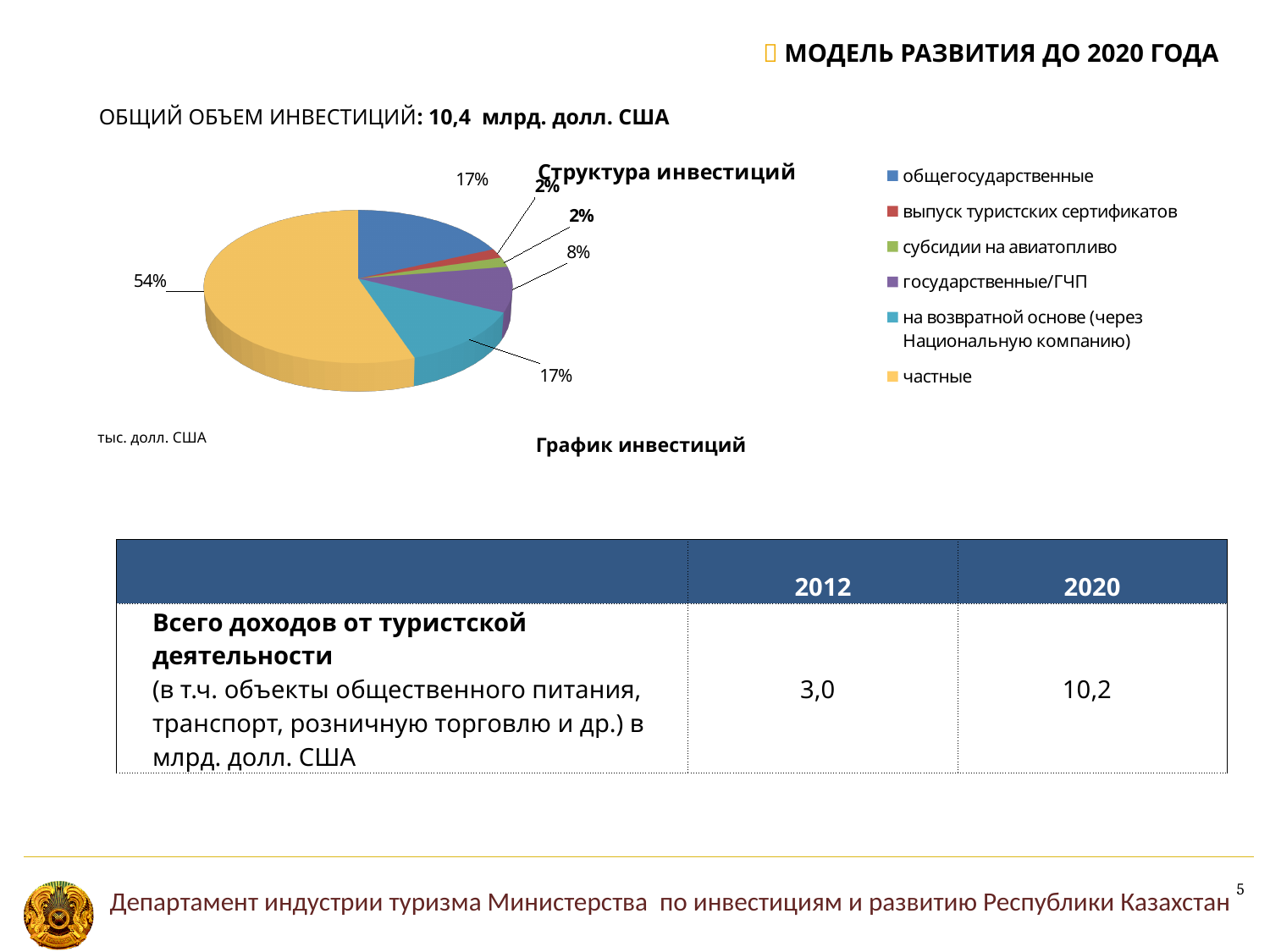
In the pie chart "Структура инвестиций", what share is labelled for "выпуск туристских сертификатов"? 2% In the pie chart "Структура инвестиций", what share is labelled for the "частные" slice? 54% What colour is the "частные" slice in the pie chart "Структура инвестиций"? Yellow In the pie chart "Структура инвестиций", what share is labelled for "на возвратной основе (через Национальную компанию)"? 17% In the pie chart "Структура инвестиций", what share is labelled for "государственные/ГЧП"? 8% In the pie chart "Структура инвестиций", which category has the largest share? частные In the pie chart "Структура инвестиций", what share is labelled for "общегосударственные"? 17% What kind of chart is "Структура инвестиций"? Pie chart In the pie chart "Структура инвестиций", which is larger: the share for "частные" or the share for "государственные/ГЧП"? частные How many categories does the legend of the pie chart "Структура инвестиций" list? 6 In the pie chart "Структура инвестиций", by how many percentage points does the "частные" share exceed the "общегосударственные" share? 37 percentage points In the pie chart "Структура инвестиций", what share is labelled for "субсидии на авиатопливо"? 2%